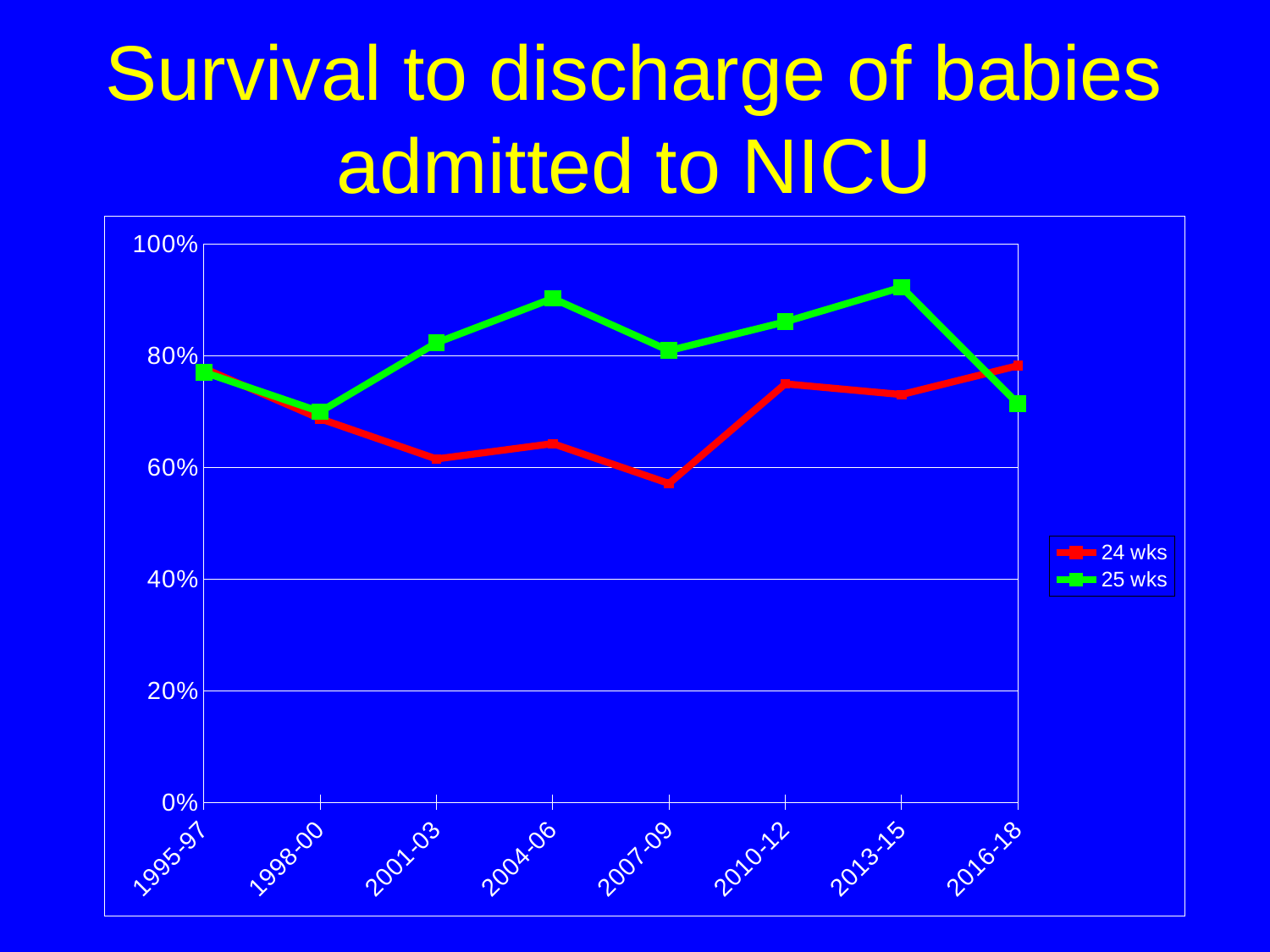
In 2016-18, which series has the higher value, 24 wks or 25 wks? 24 wks In 2004-06, which series has the higher value, 24 wks or 25 wks? 25 wks Is the value for 25 wks in 2004-06 greater or less than 80%? greater Is the value for 24 wks in 2007-09 greater or less than 60%? less Is the value for 25 wks in 2016-18 greater or less than 80%? less In which period is the 24 wks series at its lowest? 2007-09 How many series does the legend list? 2 Which colour is used for the 25 wks series? green How many time periods are shown on the x axis? 8 What is the title of the slide? Survival to discharge of babies admitted to NICU What kind of chart is shown on the slide? line chart